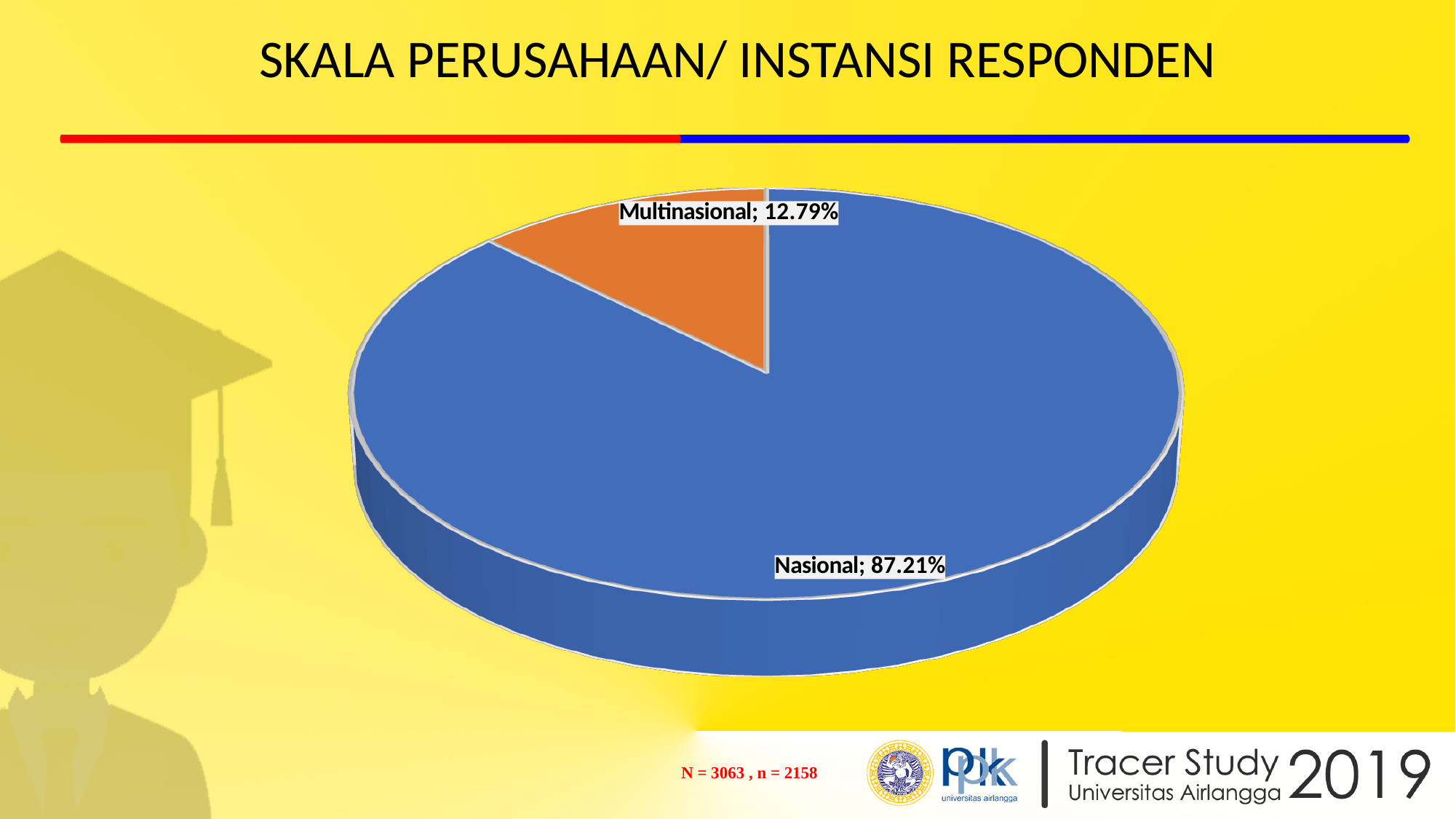
Which category has the smallest share of the pie? Multinasional What percentage of respondents are from Nasional-scale companies/institutions? 87.21% What share of the pie does the Multinasional slice represent? 12.79% What is the difference in percentage points between the Nasional and Multinasional shares? 74.42 Which category has the largest share of the pie? Nasional What is the title of the slide? SKALA PERUSAHAAN/ INSTANSI RESPONDEN Which is larger, the Nasional share or the Multinasional share? Nasional What percentage of respondents are from Multinasional-scale companies/institutions? 12.79% What colour is the Multinasional slice? Orange How many categories are shown in the pie chart? 2 What kind of chart is shown on the slide? Pie chart